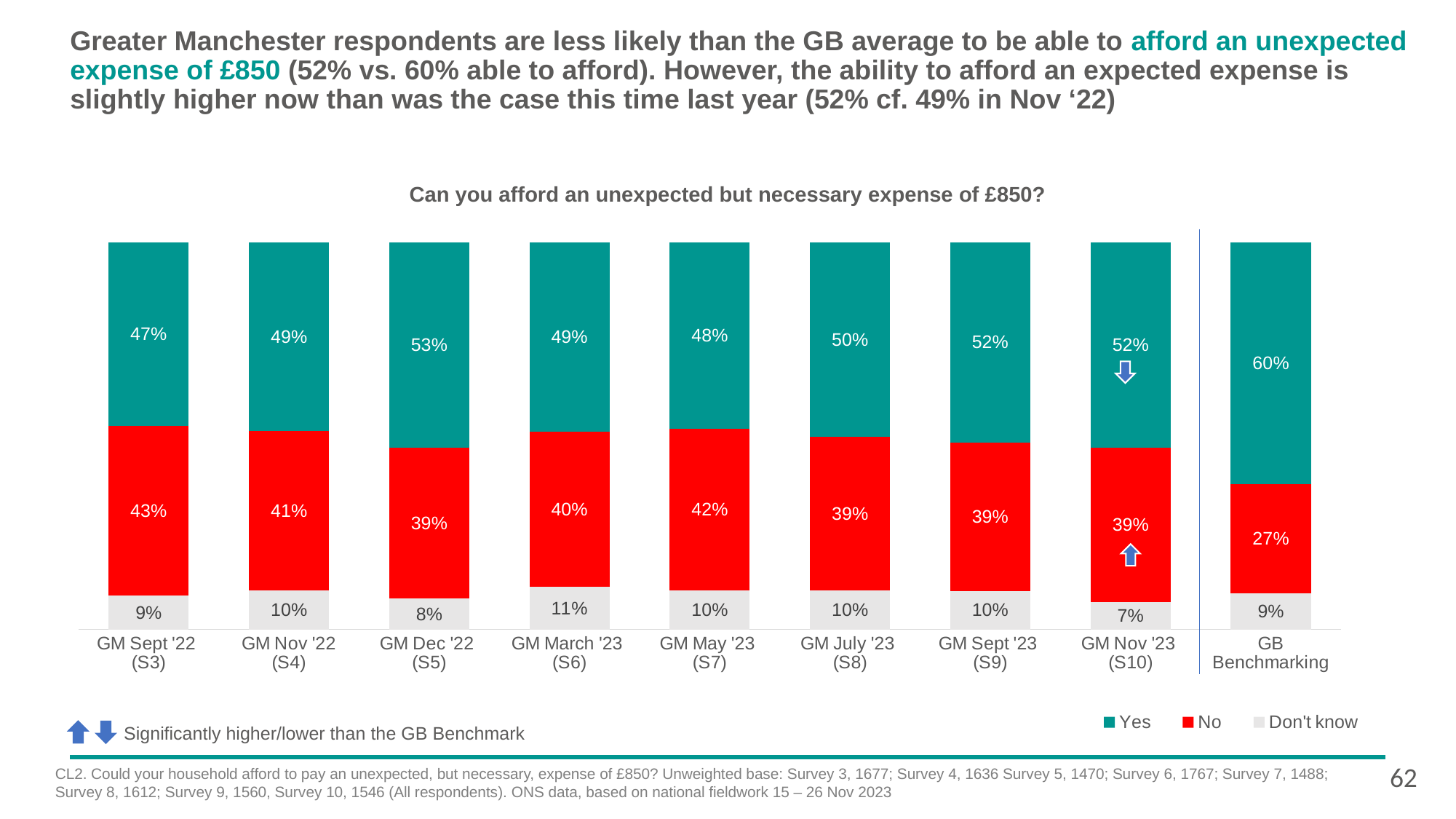
What is the No value for GB Benchmarking? 27% What is the difference in percentage points between the Yes value for GB Benchmarking and the Yes value for GM Nov '23 (S10)? 8 Which category has the highest Yes value? GB Benchmarking Which category has the highest No value? GM Sept '22 (S3) What is the Don't know value for GM March '23 (S6)? 11% How many series does the legend list? 3 What is the total of the stacked bar for GM Nov '22 (S4)? 100% How many categories are shown on the x axis? 9 What kind of chart is shown on the slide? Stacked bar chart What percentage of GM Nov '23 (S10) respondents answered Yes? 52% Which category has the lowest Don't know value? GM Nov '23 (S10) Which is larger: the No value for GM May '23 (S7) or the No value for GM July '23 (S8)? GM May '23 (S7)